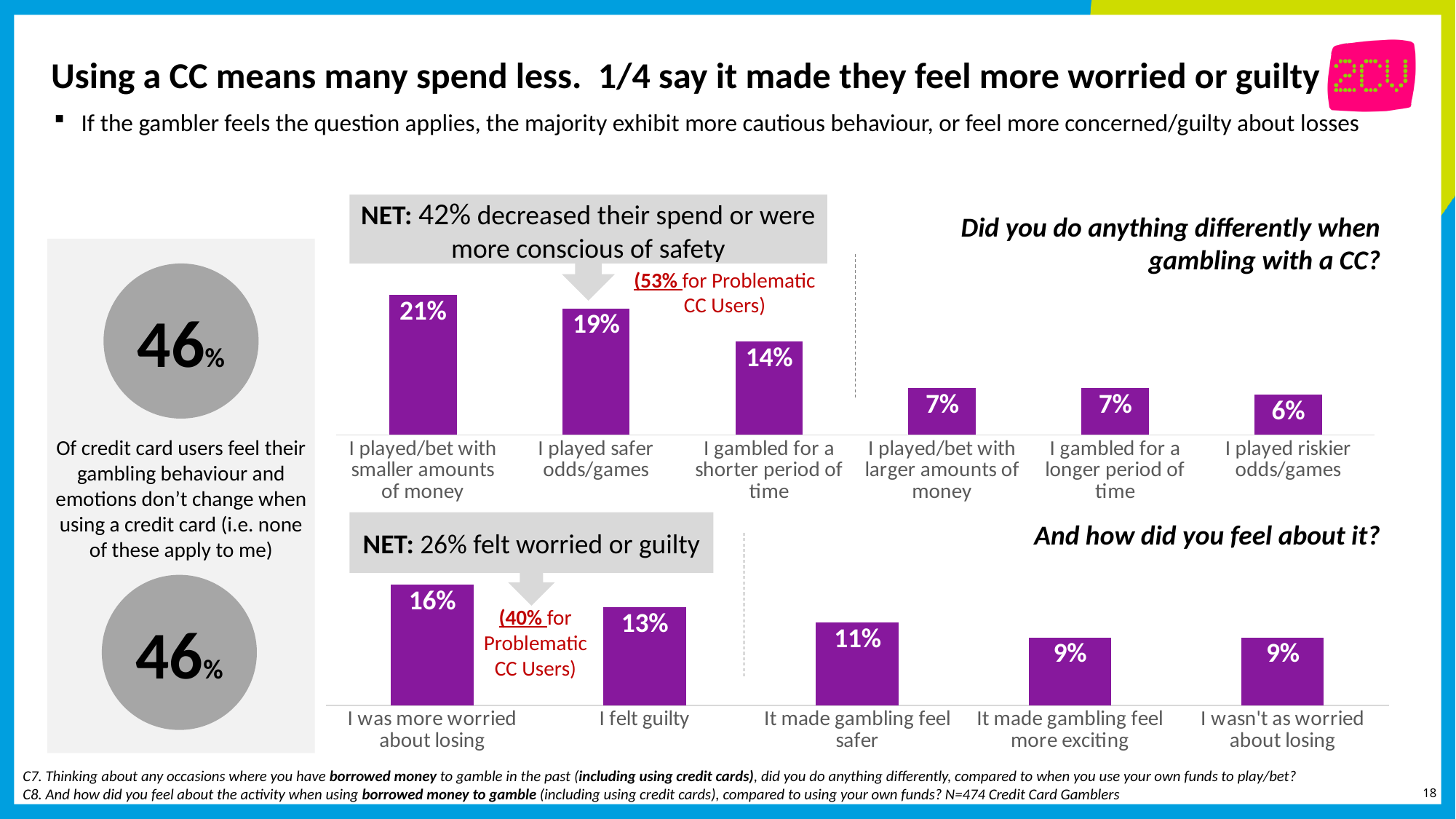
In the top chart 'Did you do anything differently when gambling with a CC?', which category has the highest value? I played/bet with smaller amounts of money In the top chart 'Did you do anything differently when gambling with a CC?', what percentage gambled for a shorter period of time? 14% How many categories are shown in the top chart 'Did you do anything differently when gambling with a CC?'? 6 How many categories are shown in the bottom chart 'And how did you feel about it?'? 5 In the top chart 'Did you do anything differently when gambling with a CC?', which category has the lowest value? I played riskier odds/games In the bottom chart 'And how did you feel about it?', which is larger: 'I felt guilty' or 'It made gambling feel more exciting'? I felt guilty What type of chart is the bottom chart 'And how did you feel about it?'? Bar chart In the top chart 'Did you do anything differently when gambling with a CC?', what is the difference between 'I played safer odds/games' and 'I played/bet with larger amounts of money'? 12 percentage points In the top chart 'Did you do anything differently when gambling with a CC?', what percentage played/bet with smaller amounts of money? 21% In the bottom chart 'And how did you feel about it?', what percentage said it made gambling feel safer? 11% In the bottom chart 'And how did you feel about it?', which category has the highest value? I was more worried about losing In the bottom chart 'And how did you feel about it?', what percentage said 'I felt guilty'? 13%